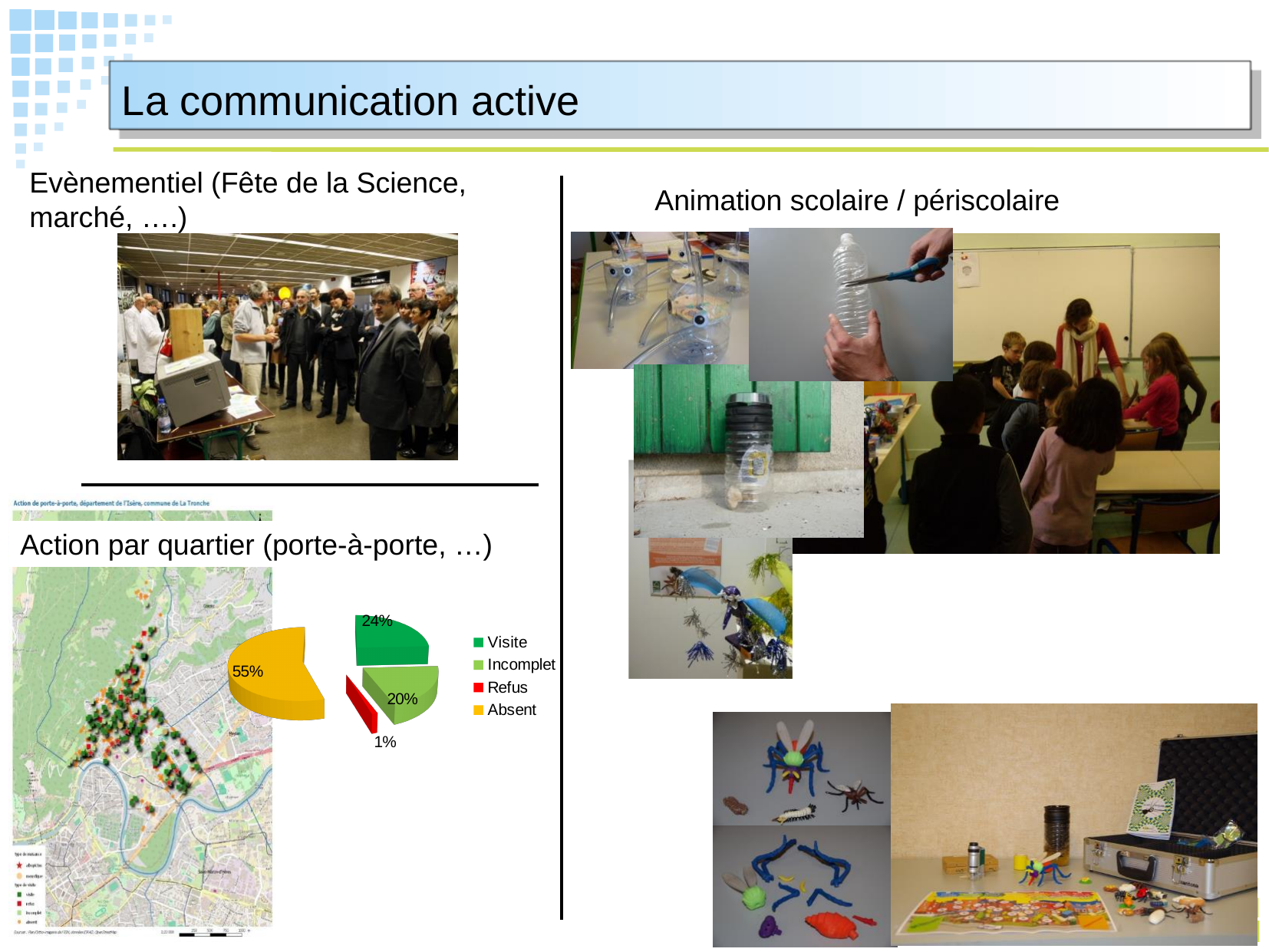
How many categories does the pie chart legend list? 4 What share of the pie chart is Refus? 1% Which is larger in the pie chart, Visite or Incomplet? Visite Which category has the largest slice in the pie chart? Absent What share of the pie chart is Visite? 24% What kind of chart is shown on the slide? pie chart Which category has the smallest slice in the pie chart? Refus What share of the pie chart is Incomplet? 20% What share of the pie chart is Absent? 55% What colour is the Absent slice in the pie chart? yellow What is the difference in percentage points between Absent and Visite in the pie chart? 31 What colour is the Refus slice in the pie chart? red